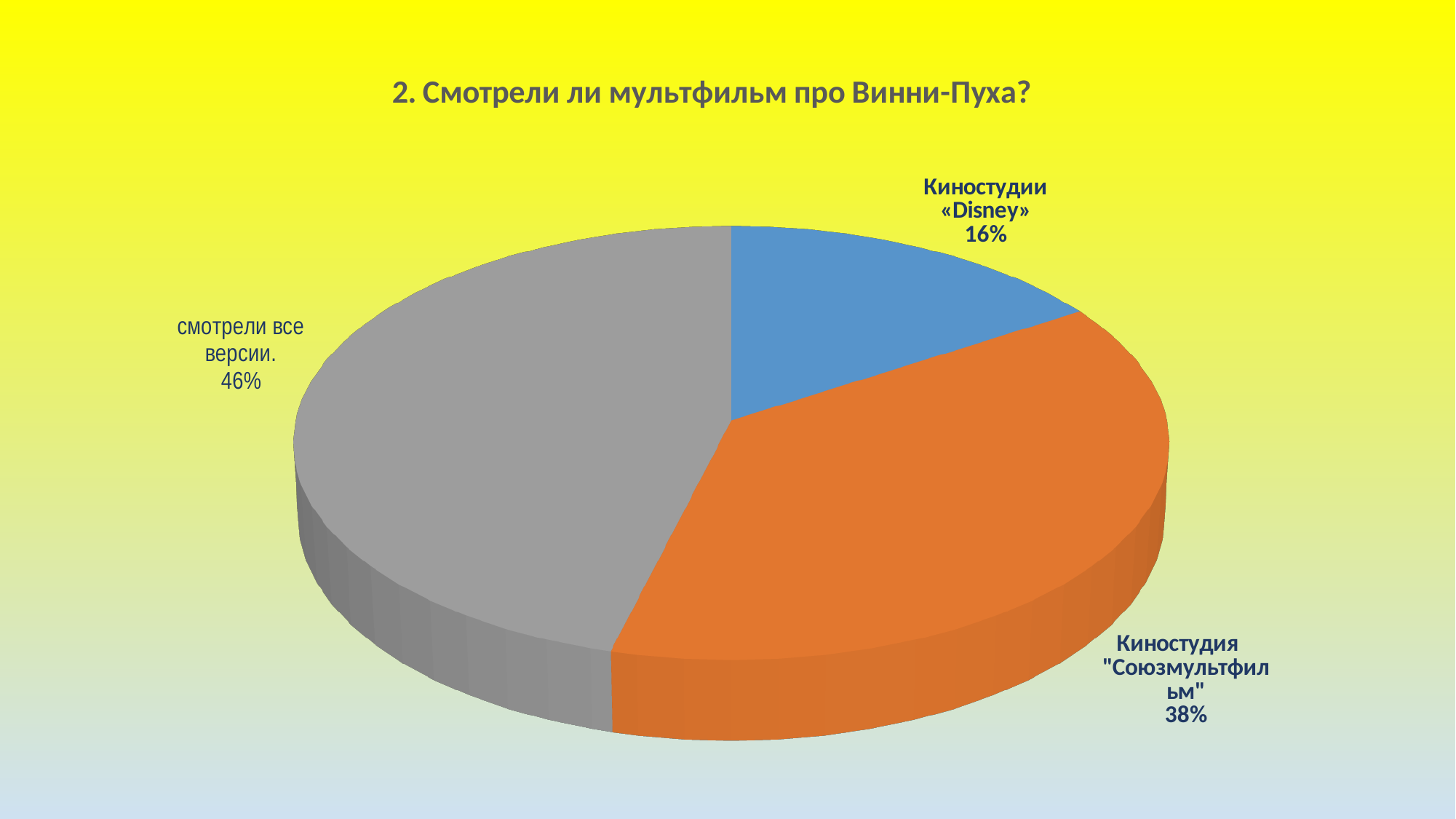
What colour is the slice for Киностудии «Disney»? blue What kind of chart is shown on the slide? pie chart What share of the pie is labelled for Киностудии «Disney»? 16% What is the difference in percentage points between смотрели все версии and Киностудия "Союзмультфильм"? 8 What share of the pie is labelled for смотрели все версии? 46% Which is larger: the slice for Киностудии «Disney» or the slice for Киностудия "Союзмультфильм"? Киностудия "Союзмультфильм" What is the title of the chart? 2. Смотрели ли мультфильм про Винни-Пуха? What share of the pie is labelled for Киностудия "Союзмультфильм"? 38% Which category has the smallest slice of the pie? Киностудии «Disney» Which category has the largest slice of the pie? смотрели все версии What is the difference in percentage points between Киностудия "Союзмультфильм" and Киностудии «Disney»? 22 How many slices does the pie chart have? 3